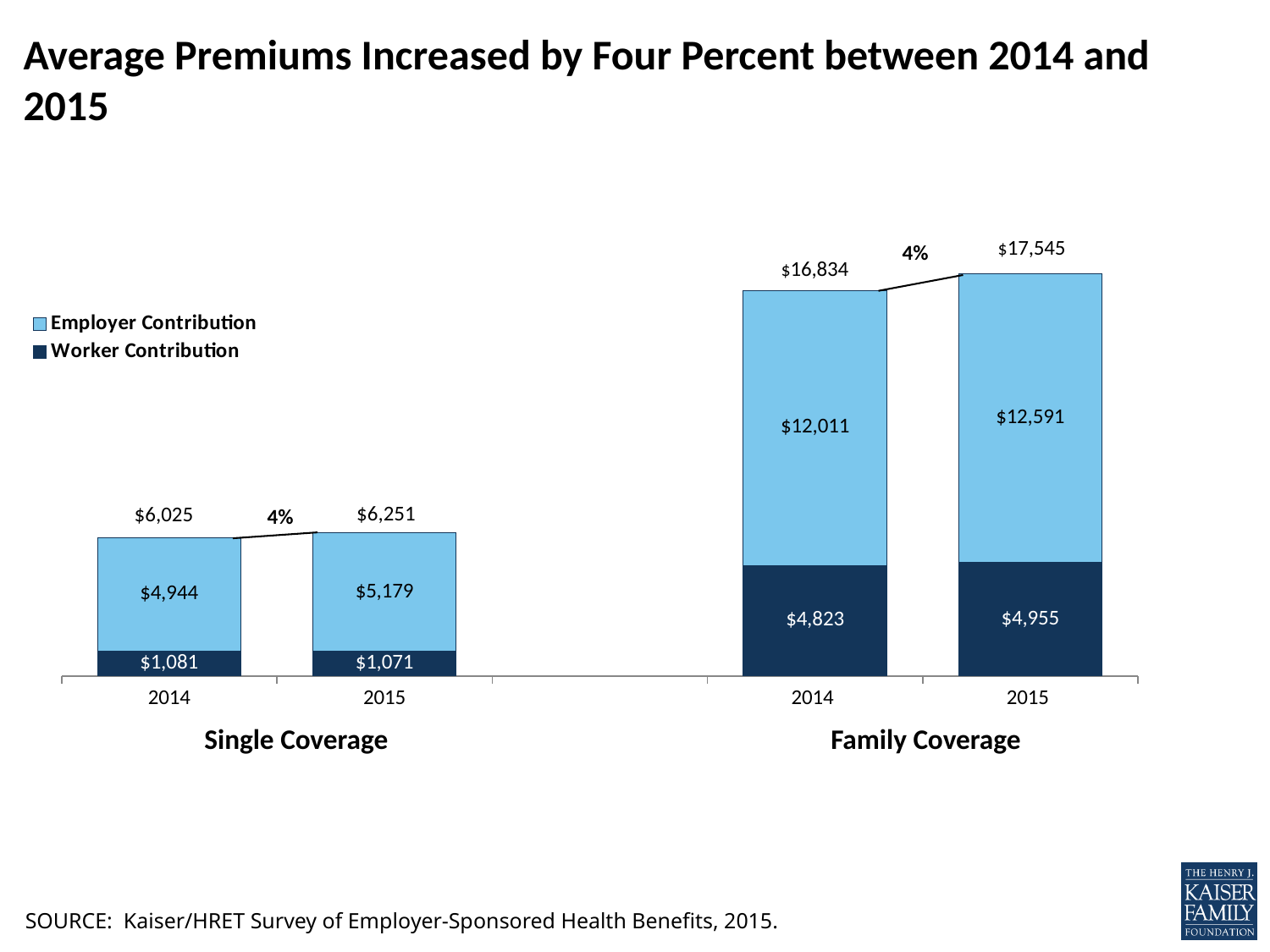
What is the total premium for Single Coverage in 2014? $6,025 What is the difference between the Employer Contribution for Family Coverage in 2015 and in 2014? $580 What kind of chart is shown on the slide? Stacked bar chart What is the total premium for Family Coverage in 2015? $17,545 What is the Employer Contribution for Single Coverage in 2015? $5,179 Which bar has the lowest total premium? Single Coverage 2014 Which is larger, the Worker Contribution for Family Coverage in 2015 or the Employer Contribution for Single Coverage in 2015? Employer Contribution for Single Coverage in 2015 Which bar has the highest total premium? Family Coverage 2015 By what percentage did the Family Coverage premium increase from 2014 to 2015, as labeled on the chart? 4% How many series does the legend list? 2 What is the Worker Contribution for Family Coverage in 2014? $4,823 What is the difference between the Worker Contribution for Single Coverage in 2014 and in 2015? $10